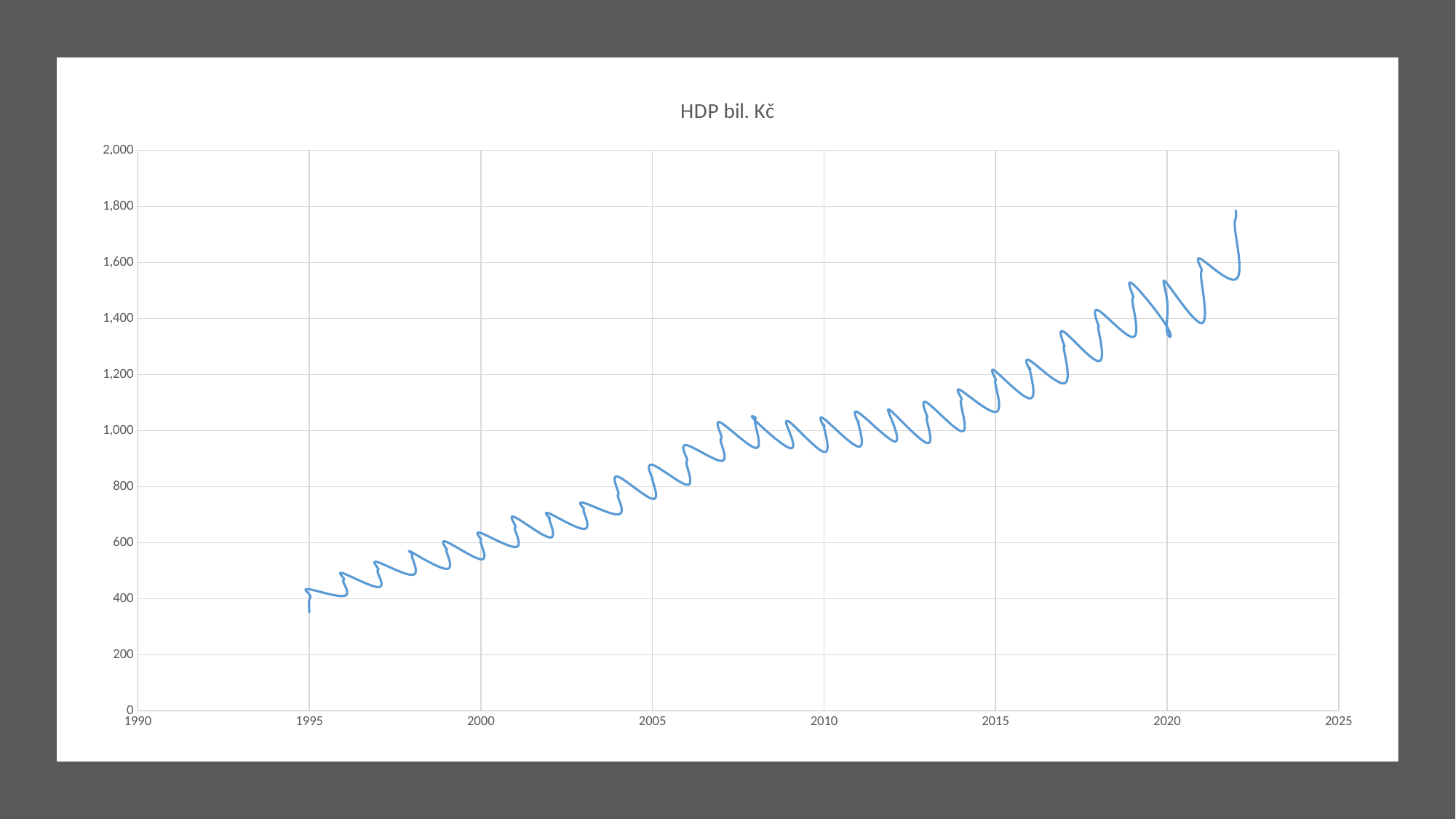
Do the values of the line generally rise or fall from 1995 to 2022? rise What is the highest value labelled on the vertical axis? 2,000 Is the value of the line around 2005 greater or less than 1,000? less Is the value of the line around 1995 greater or less than 600? less Does the line reach its highest value at the start or at the end of the series? end Is the value of the line around 2010 greater or less than 800? greater Is the value of the line around 2015 larger or smaller than the value around 2000? larger Does the line reach its lowest value at the start or at the end of the series? start What is the title of the chart? HDP bil. Kč What kind of chart is shown on the slide? line chart